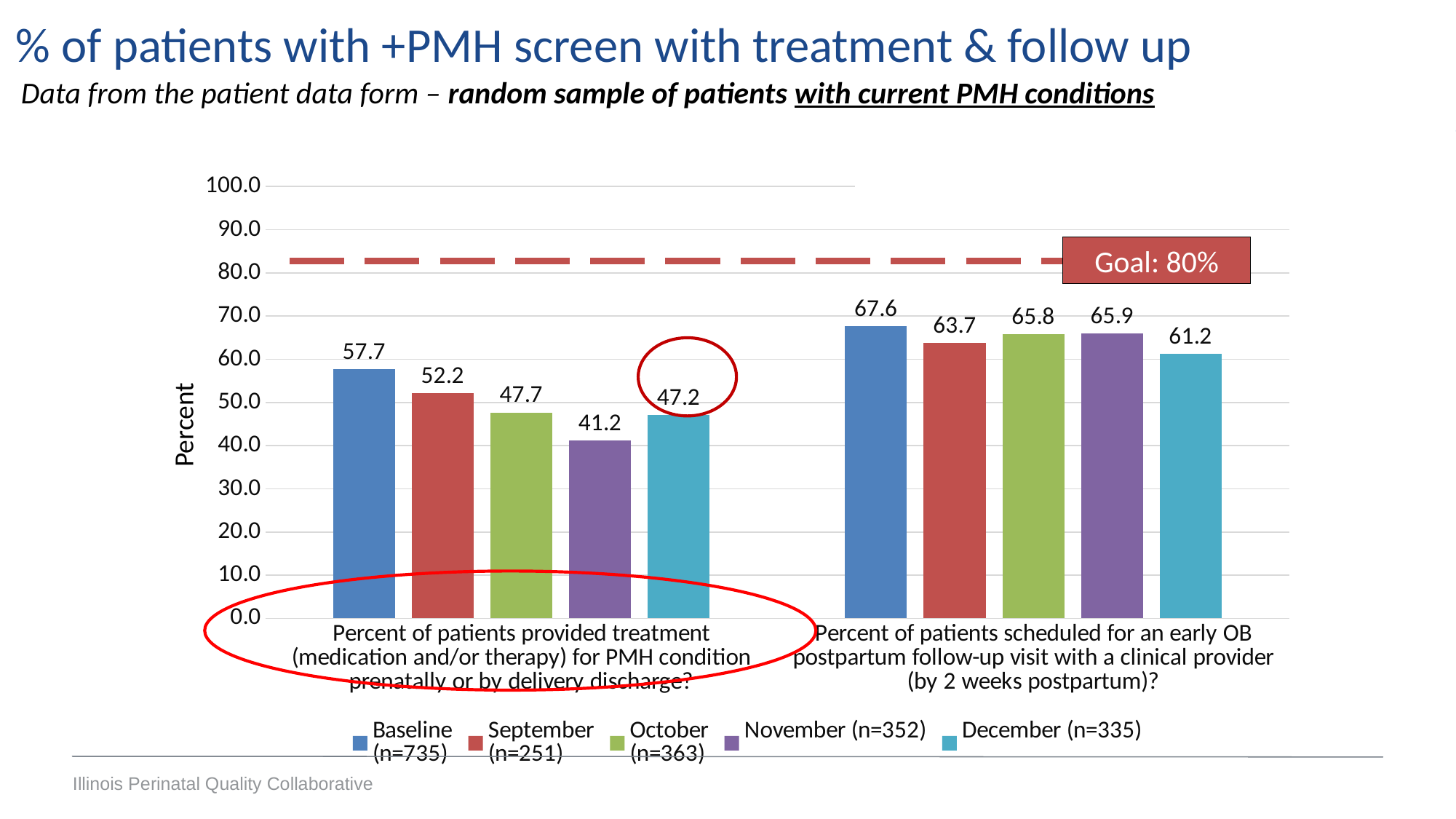
What is the November value for the treatment category? 41.2 What goal value is marked by the dashed line on the chart? 80% What is the Baseline value for 'Percent of patients provided treatment (medication and/or therapy) for PMH condition prenatally or by delivery discharge?' 57.7 Which is larger: the October value for the treatment category or the October value for the follow-up visit category? Follow-up visit category (65.8) Which series has the highest value for the early OB postpartum follow-up visit category? Baseline (n=735) How many series does the legend list? 5 What is the difference between the Baseline and December values for the treatment category? 10.5 What is the December value for 'Percent of patients scheduled for an early OB postpartum follow-up visit with a clinical provider (by 2 weeks postpartum)?' 61.2 How many categories are shown on the x axis? 2 Which series has the lowest value for the treatment category? November (n=352) What is the label of the y axis? Percent What kind of chart is shown on the slide? Bar chart